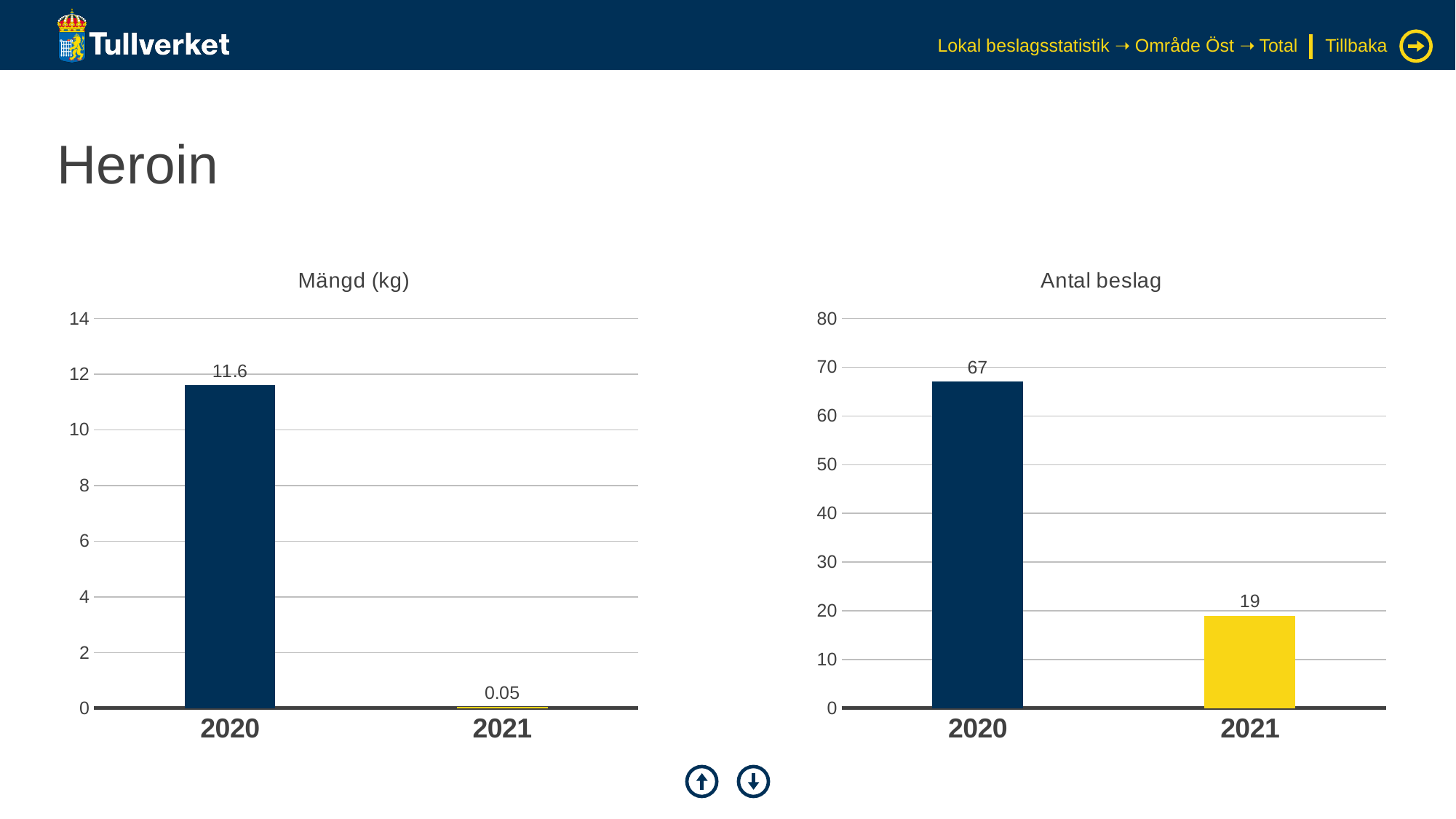
How many categories are shown on the x axis of the 'Antal beslag' chart? 2 In the 'Antal beslag' chart, what is the value for 2020? 67 In the 'Antal beslag' chart, what is the value for 2021? 19 In the 'Mängd (kg)' chart, which year has the lowest value? 2021 In the 'Antal beslag' chart, what is the difference between the values for 2020 and 2021? 48 In the 'Antal beslag' chart, which year has the highest value? 2020 In the 'Mängd (kg)' chart, is the value for 2020 greater or less than 10? greater In the 'Antal beslag' chart, is the value for 2021 greater or less than 20? less What kind of chart is the 'Mängd (kg)' chart? bar chart In the 'Antal beslag' chart, do the values rise or fall from 2020 to 2021? fall In the 'Mängd (kg)' chart, what is the value for 2020? 11.6 In the 'Mängd (kg)' chart, what is the value for 2021? 0.05